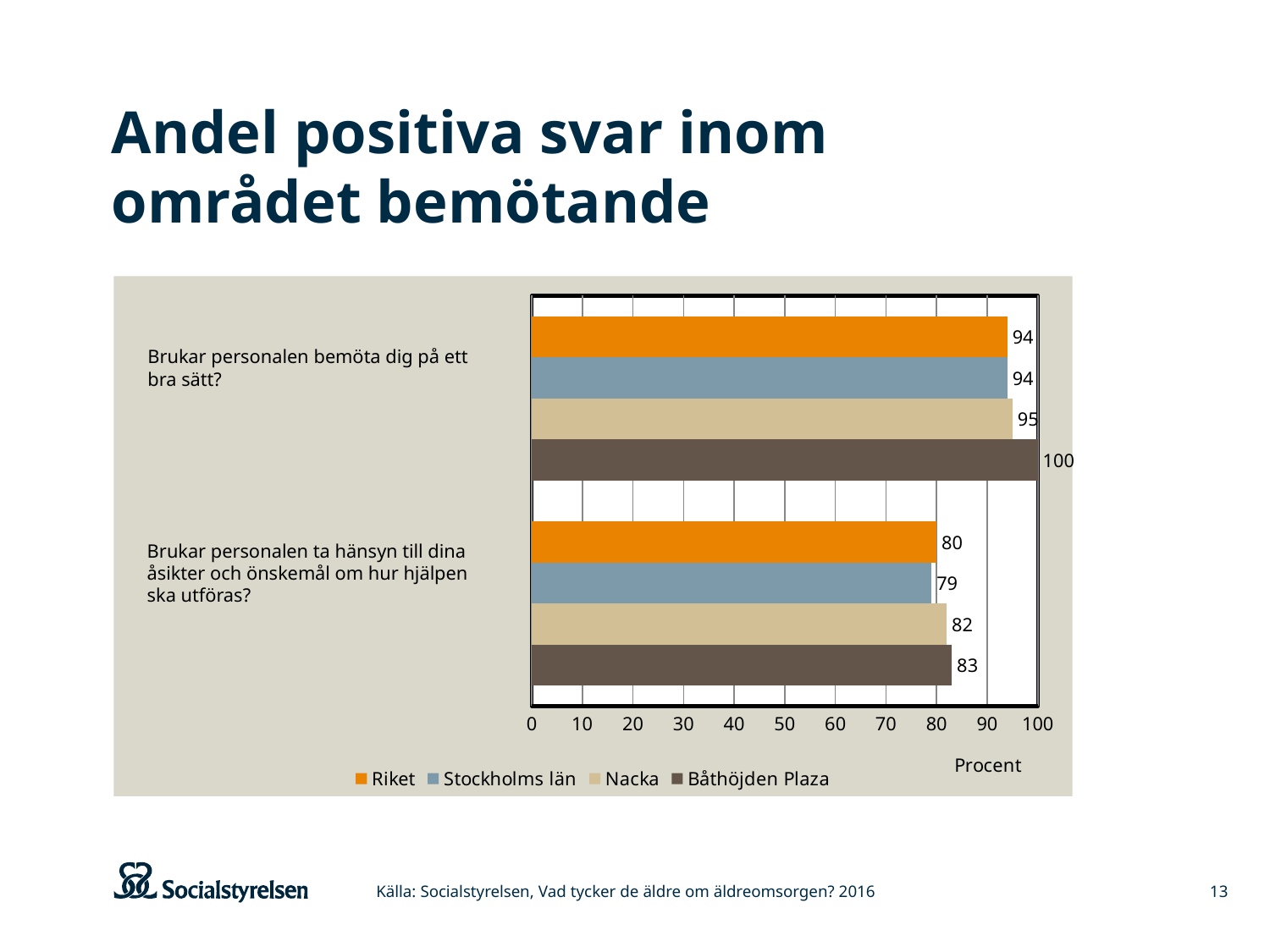
How many questions (categories) are shown on the chart? 2 How many series does the legend list? 4 What is the value for Båthöjden Plaza on the question "Brukar personalen bemöta dig på ett bra sätt?"? 100 What is the difference between the Båthöjden Plaza value and the Riket value on the question "Brukar personalen bemöta dig på ett bra sätt?"? 6 What kind of chart is shown on the slide? Bar chart What is the value for Stockholms län on the question "Brukar personalen ta hänsyn till dina åsikter och önskemål om hur hjälpen ska utföras?"? 79 What is the label on the horizontal axis of the chart? Procent Which series has the highest value on the question "Brukar personalen ta hänsyn till dina åsikter och önskemål om hur hjälpen ska utföras?"? Båthöjden Plaza What is the value for Nacka on the question "Brukar personalen bemöta dig på ett bra sätt?"? 95 What is the value for Riket on the question "Brukar personalen ta hänsyn till dina åsikter och önskemål om hur hjälpen ska utföras?"? 80 Which is larger: the Nacka value or the Stockholms län value on the question "Brukar personalen ta hänsyn till dina åsikter och önskemål om hur hjälpen ska utföras?"? Nacka Which series has the lowest value on the question "Brukar personalen ta hänsyn till dina åsikter och önskemål om hur hjälpen ska utföras?"? Stockholms län